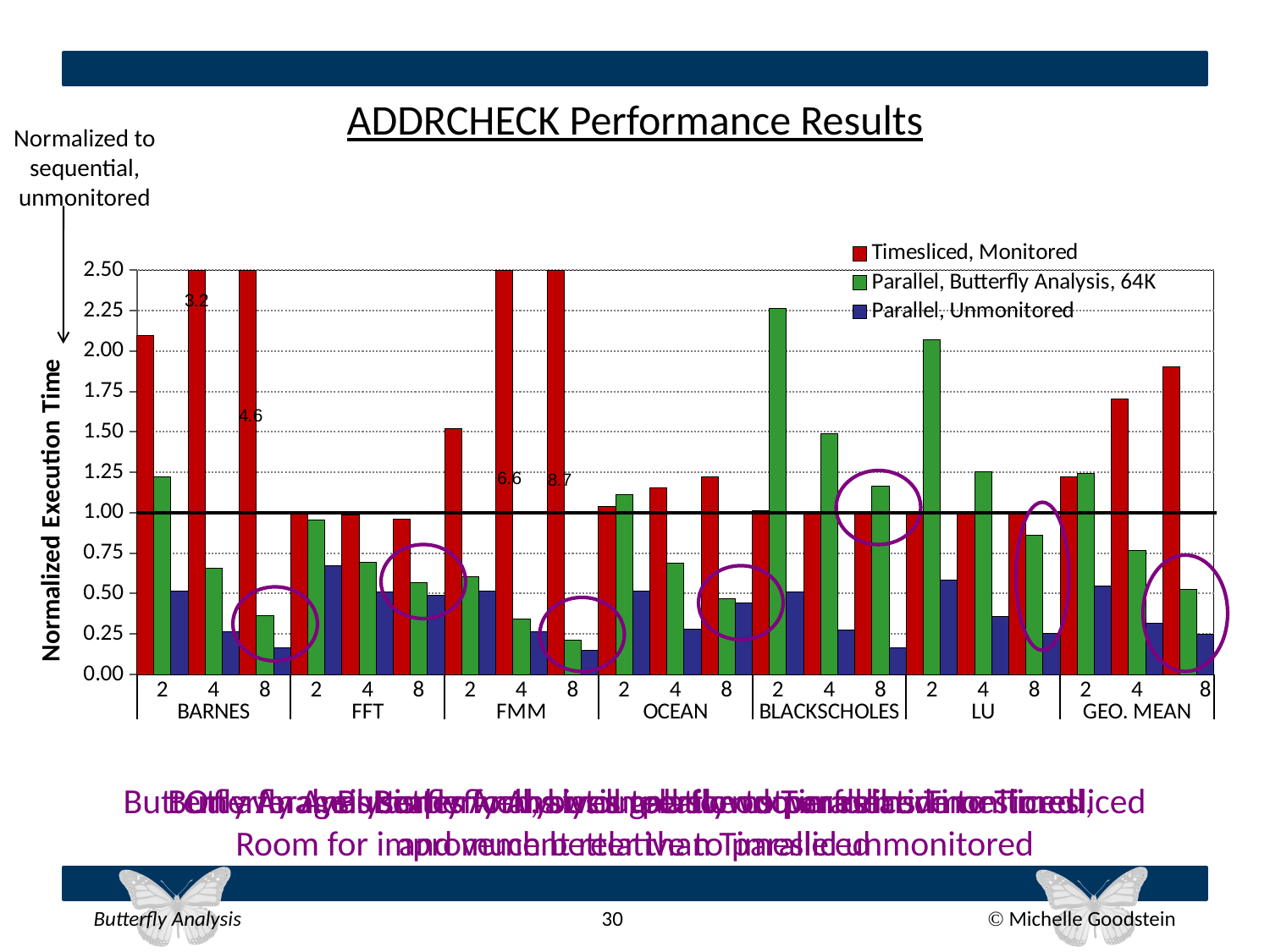
Is the Parallel, Butterfly Analysis, 64K value for BLACKSCHOLES at 2 threads greater or less than 2.00? greater What is the title of the chart? ADDRCHECK Performance Results What is the Timesliced, Monitored value for BARNES at 8 threads? 4.6 What is the label on the vertical axis? Normalized Execution Time What kind of chart is shown on the slide? bar chart How many series does the legend list? 3 Is the Parallel, Unmonitored value for BARNES at 8 threads greater or less than 0.25? less What is the Timesliced, Monitored value for FMM at 8 threads? 8.7 How many benchmark groups are shown along the x axis? 7 What is the Timesliced, Monitored value for FMM at 4 threads? 6.6 What is the difference between the Timesliced, Monitored values for FMM at 8 threads and BARNES at 8 threads? 4.1 What is the Timesliced, Monitored value for BARNES at 4 threads? 3.2